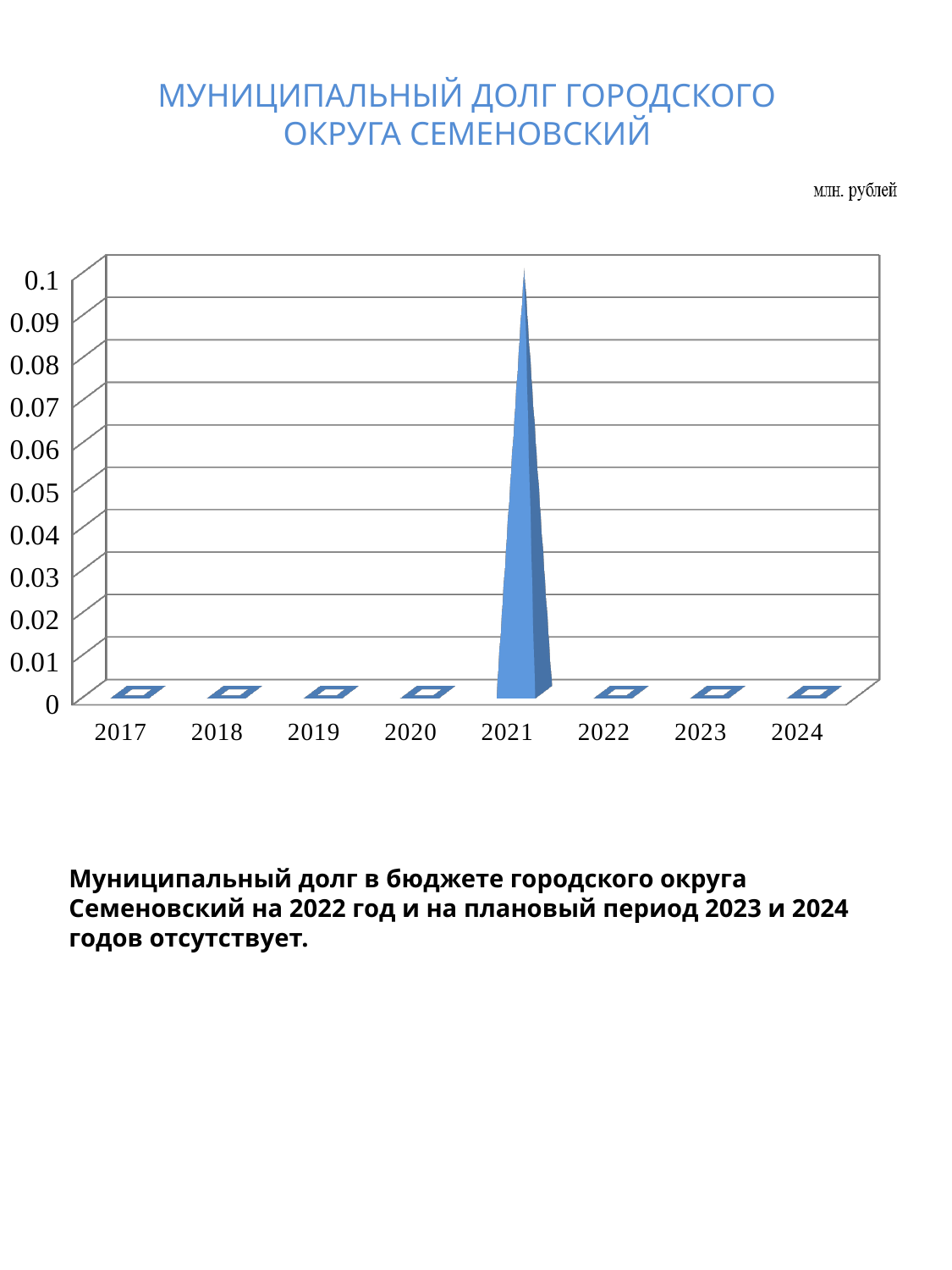
Is the value for 2021 greater or less than 0.05? greater What is the value for 2024 in the chart? 0 What is the value for 2017 in the chart? 0 What is the title of the slide containing the chart? МУНИЦИПАЛЬНЫЙ ДОЛГ ГОРОДСКОГО ОКРУГА СЕМЕНОВСКИЙ What is the value for 2022 in the chart? 0 Which is larger, the value for 2021 or the value for 2020? 2021 What kind of chart is shown on the slide? bar chart What unit is indicated above the chart? млн. рублей Which year has the highest municipal debt value in the chart? 2021 How many years are shown on the x axis of the chart? 8 What is the last year shown on the x axis of the chart? 2024 What is the first year shown on the x axis of the chart? 2017